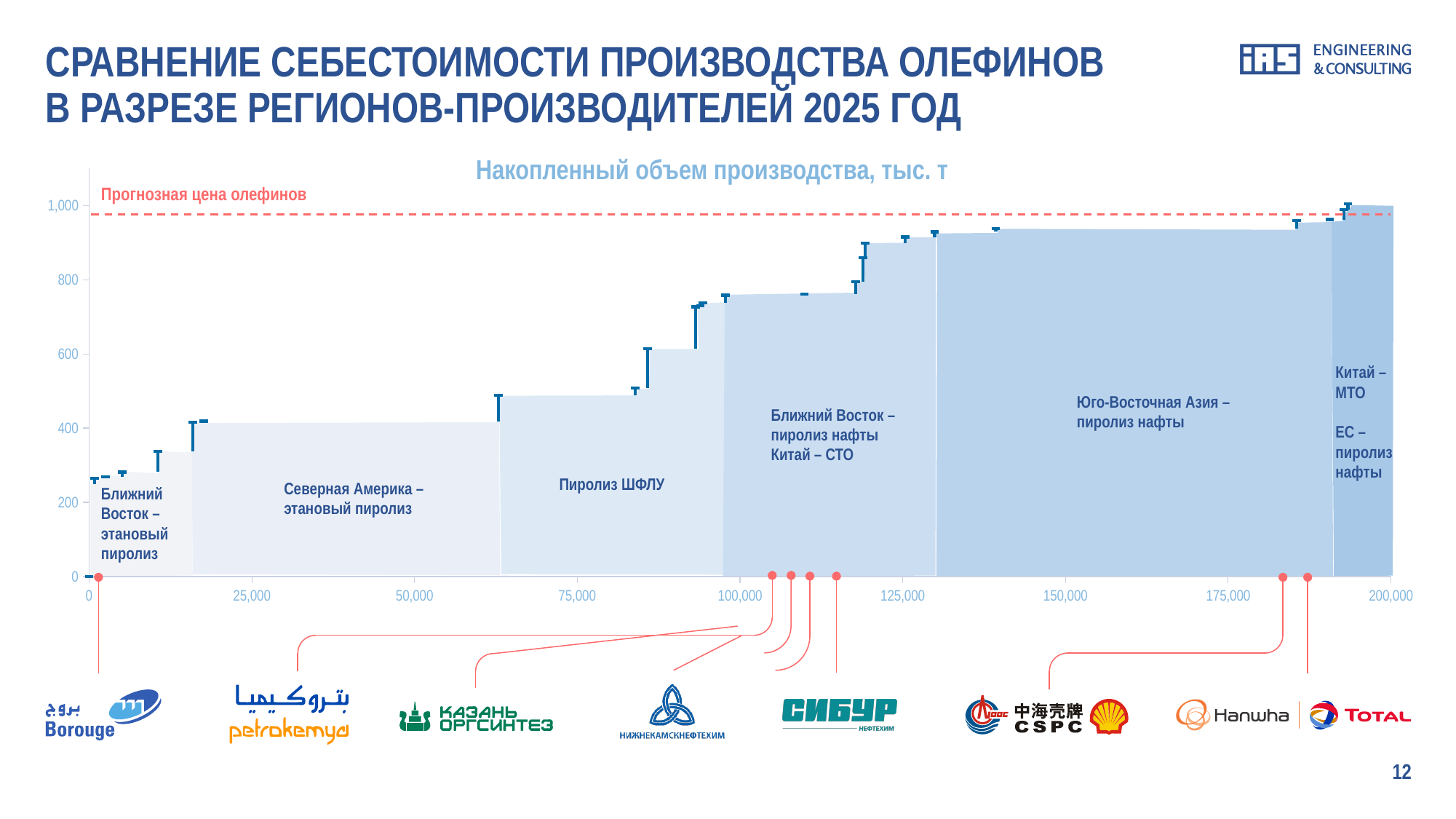
What does the red dashed horizontal line on the chart represent? Прогнозная цена олефинов What is the title of the x axis of the chart? Накопленный объем производства, тыс. т Is the dashed line 'Прогнозная цена олефинов' above or below 800 on the y axis? above Which region segment has the lowest production cost (leftmost on the curve)? Ближний Восток – этановый пиролиз Which segment has a higher cost level: Пиролиз ШФЛУ or Северная Америка – этановый пиролиз? Пиролиз ШФЛУ Is the cost level for the Пиролиз ШФЛУ segment greater or less than 400? greater Is the cost level for the Ближний Восток – этановый пиролиз segment greater or less than 400? less What kind of chart is shown on the slide? Stepped area chart (cost curve) Do the values rise or fall as cumulative production increases along the x axis? Rise